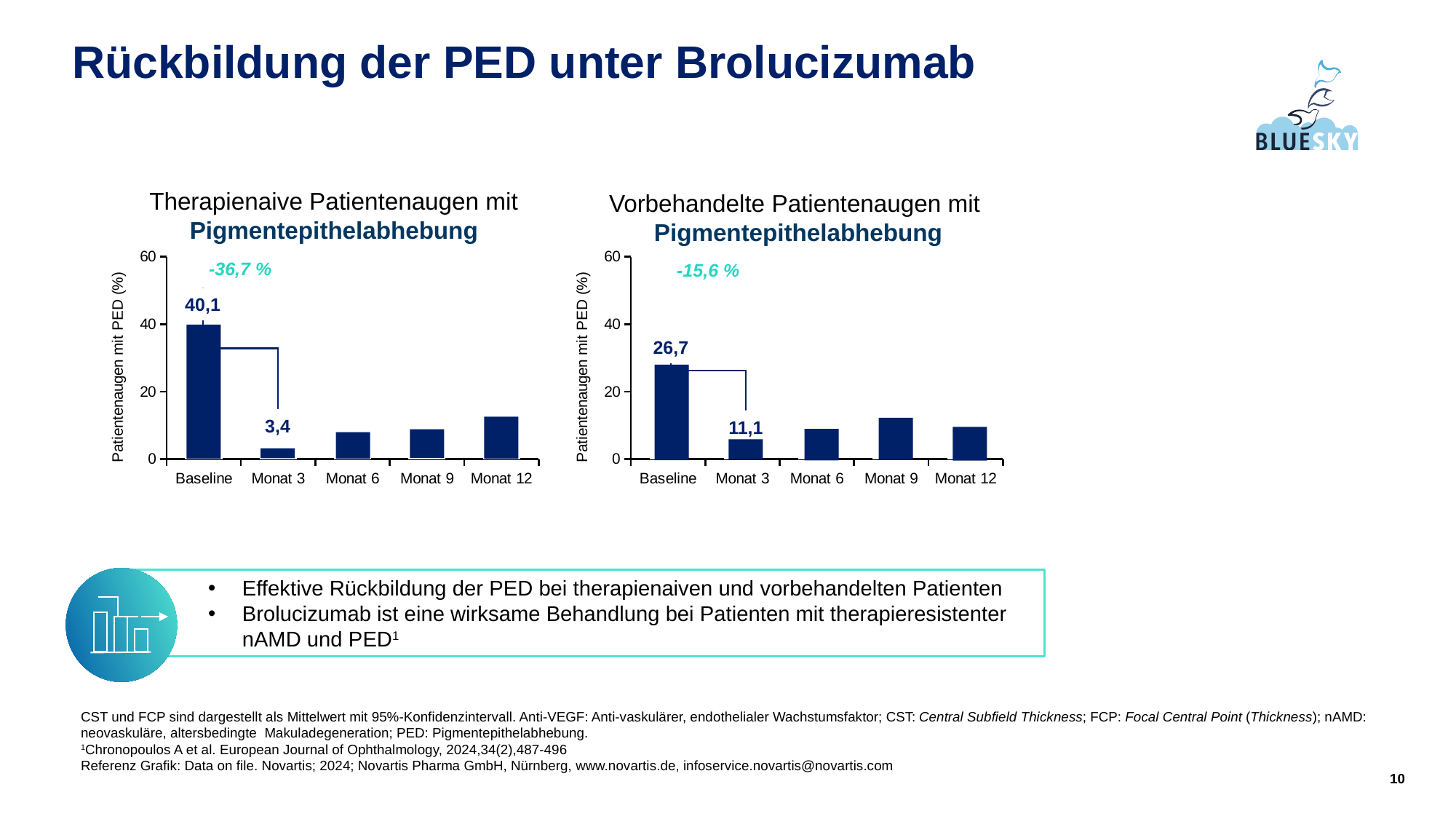
In the chart for therapienaive Patientenaugen, what is the value at Baseline? 40,1 In the chart for therapienaive Patientenaugen, which time point has the highest value? Baseline In the chart for vorbehandelte Patientenaugen, what is the difference between the Baseline value and the Monat 3 value? 15,6 In the chart for therapienaive Patientenaugen, what is the value at Monat 3? 3,4 In the chart for vorbehandelte Patientenaugen, which time point has the highest value? Baseline How many time points are shown on the x axis of the chart for vorbehandelte Patientenaugen? 5 In the chart for vorbehandelte Patientenaugen, what is the value at Baseline? 26,7 What kind of chart is used for the therapienaive Patientenaugen data? bar chart In the chart for therapienaive Patientenaugen, is the value for Monat 12 greater or less than 20? less In the chart for therapienaive Patientenaugen, what is the difference between the Baseline value and the Monat 3 value? 36,7 In the chart for vorbehandelte Patientenaugen, what is the value at Monat 3? 11,1 In the chart for therapienaive Patientenaugen, which time point has the lowest value? Monat 3